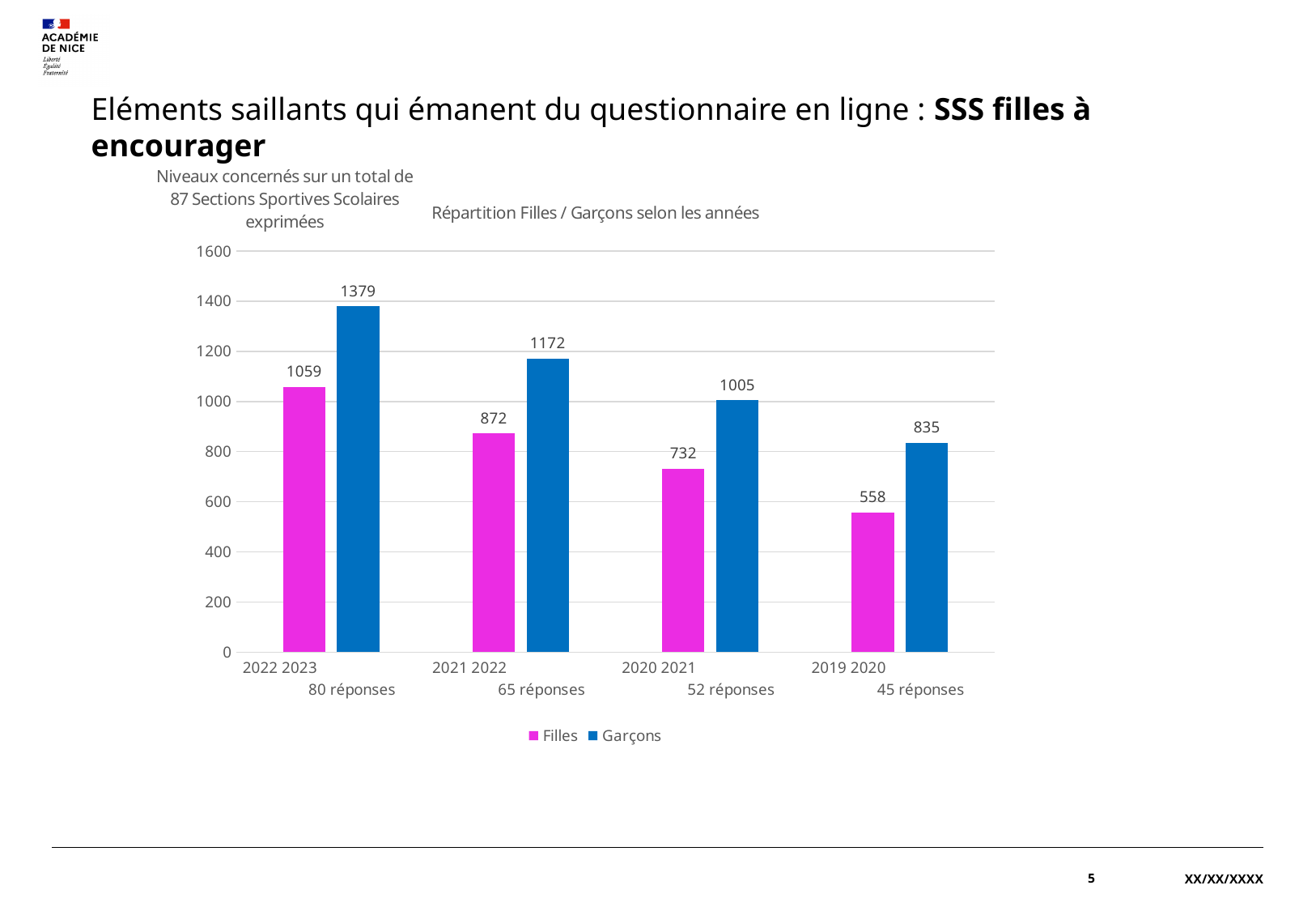
What is the difference between Garçons and Filles in 2021 2022? 300 What is the value for Garçons in 2019 2020? 835 Which is larger in 2020 2021, Filles or Garçons? Garçons Which year has the lowest value for Filles? 2019 2020 What kind of chart is shown? bar chart Do the Filles values rise or fall from 2022 2023 to 2019 2020 along the x axis? fall How many year categories are shown on the x axis? 4 Is the value for Filles in 2020 2021 greater or less than 800? less Which year has the highest value for Garçons? 2022 2023 How many series does the legend list? 2 What is the value for Filles in 2022 2023? 1059 What is the value for Garçons in 2020 2021? 1005